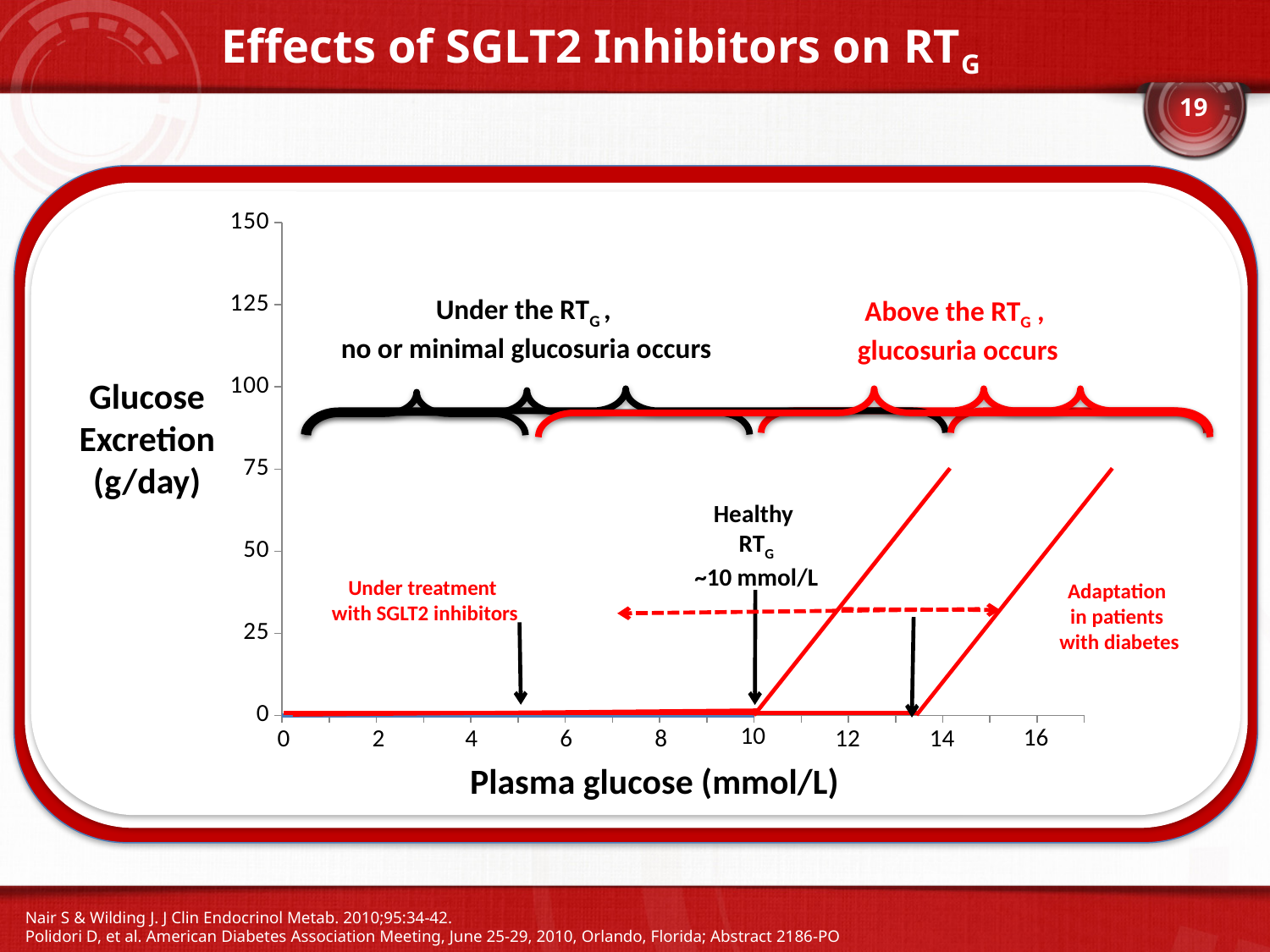
What is the title of the slide's chart? Effects of SGLT2 Inhibitors on RTG What is the highest value labelled on the x axis? 16 What value does the chart give for the healthy RTG? ~10 mmol/L Which occurs at a higher plasma glucose: the healthy RTG or the adapted RTG in patients with diabetes? adaptation in patients with diabetes For the healthy RTG line, at a plasma glucose of 12 mmol/L, is glucose excretion greater or less than 25 g/day? greater What is the label of the x axis? Plasma glucose (mmol/L) What kind of chart is shown on the slide? line chart How many labelled tick values are there on the x axis? 9 At a plasma glucose of 6 mmol/L, is glucose excretion greater or less than 25 g/day? less Above the RTG, does glucose excretion rise or fall as plasma glucose increases? rise What is the highest value shown on the y axis (Glucose Excretion)? 150 According to the chart, what happens to glucosuria under the RTG? no or minimal glucosuria occurs